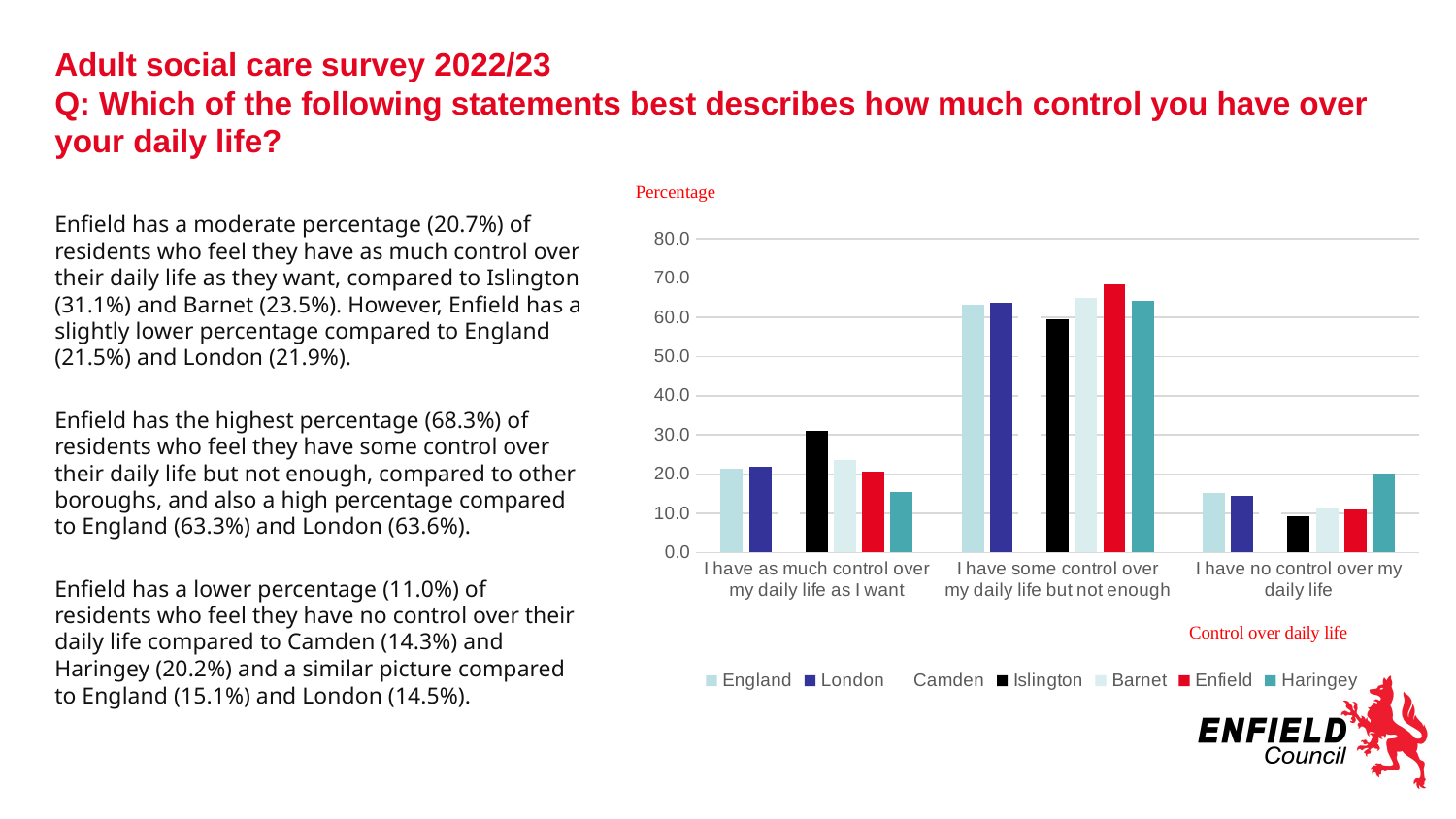
Is the value for England in 'I have no control over my daily life' greater or less than 20.0? less What kind of chart is shown on the slide? bar chart Which series has the lowest bar for 'I have no control over my daily life'? Islington Which series has the highest bar for 'I have some control over my daily life but not enough'? Enfield Which series has the highest bar for 'I have no control over my daily life'? Haringey Is the value for Haringey in 'I have as much control over my daily life as I want' greater or less than 20.0? less How many categories are shown on the x axis of the chart? 3 How many series does the chart legend list? 7 For 'I have as much control over my daily life as I want', which is larger: Barnet or Enfield? Barnet Which series has the highest bar for 'I have as much control over my daily life as I want'? Islington What is the title of the vertical axis of the chart? Percentage Is the value for Enfield in 'I have some control over my daily life but not enough' greater or less than 60.0? greater